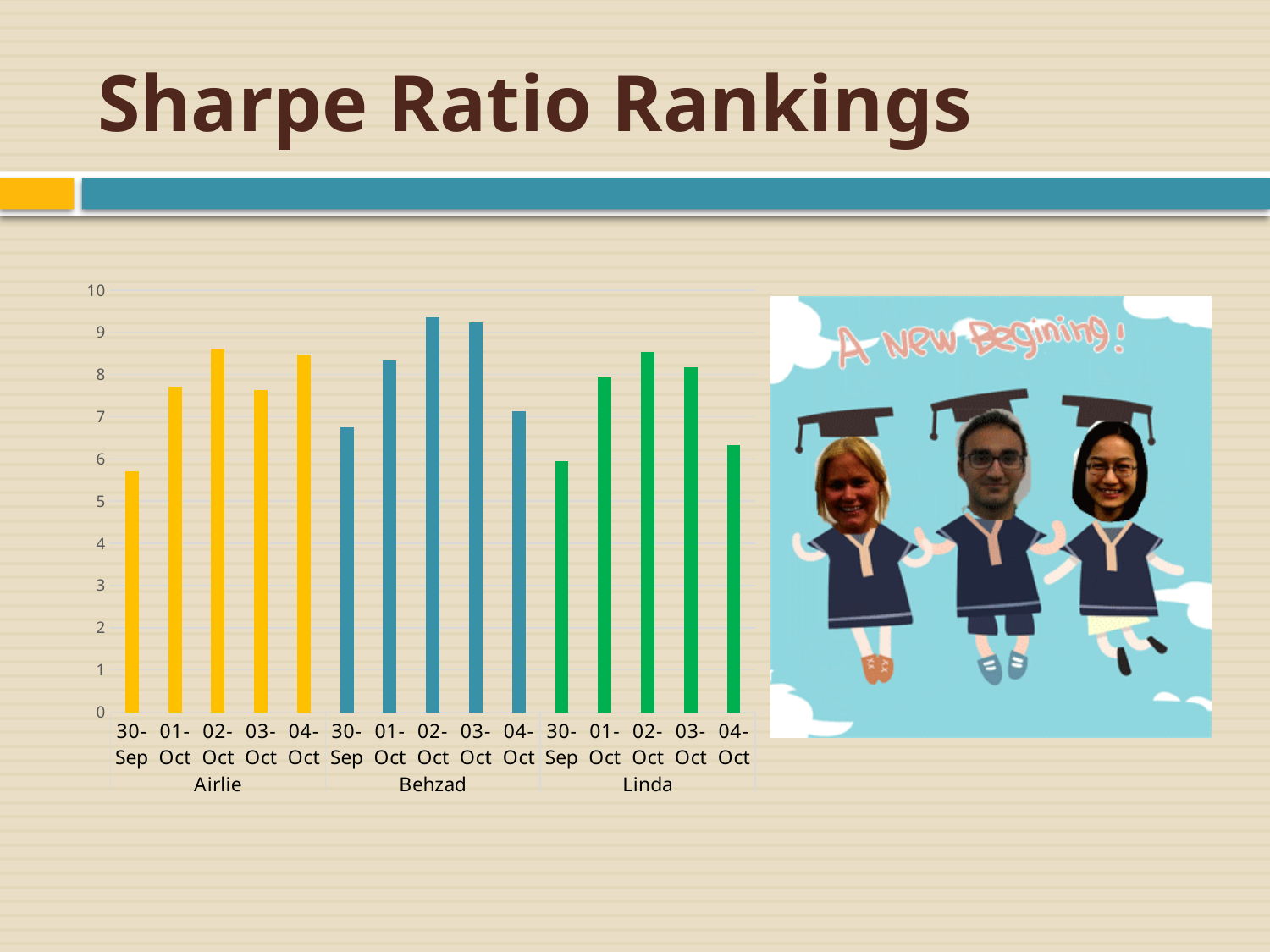
Is the value for Airlie on 01-Oct greater or less than 7? greater Which is larger, the value for Behzad on 30-Sep or the value for Airlie on 30-Sep? Behzad on 30-Sep Is the value for Behzad on 30-Sep greater or less than 7? less Is the value for Airlie on 30-Sep greater or less than 6? less Which date has the lowest value within Airlie's group? 30-Sep How many people (groups) are shown on the x axis of the chart? 3 What kind of chart is shown on the slide? bar chart How many bars are plotted in the chart? 15 What is the title of the slide containing the chart? Sharpe Ratio Rankings Which is larger, Linda's value on 02-Oct or Linda's value on 04-Oct? 02-Oct